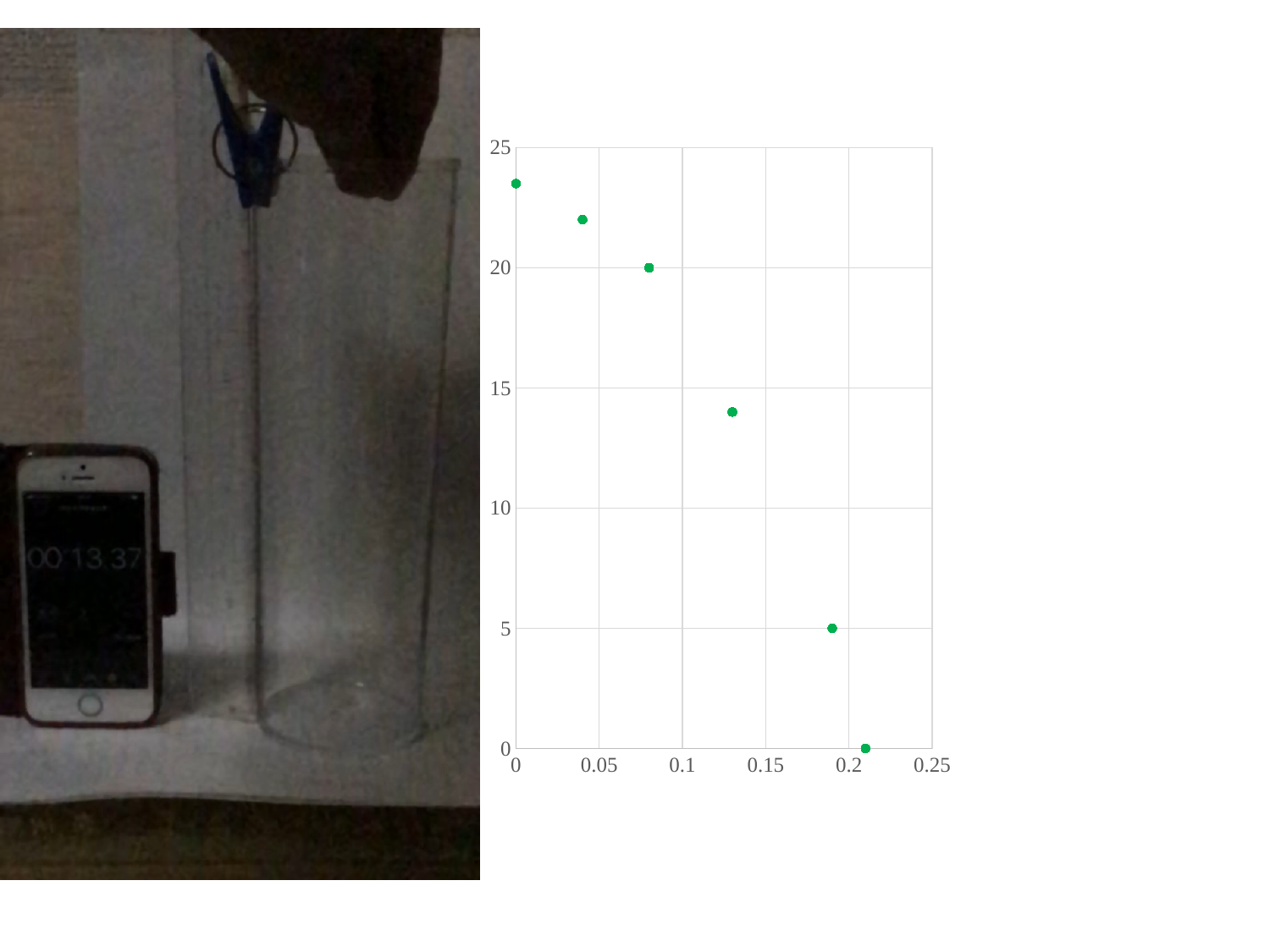
What is the y value of the rightmost point on the chart? 0 What is the highest value shown on the y axis? 25 Is the y value of the second point from the left greater or less than 20? greater Is the y value of the leftmost point greater or less than 20? greater Which point has the highest y value, the leftmost or the rightmost? the leftmost What kind of chart is shown on the slide? scatter chart What is the x value of the leftmost point on the chart? 0 Is the y value of the fourth point from the left greater or less than 15? less How many data points are plotted on the chart? 6 Do the plotted values rise or fall as the x value increases? fall What is the y value of the second point from the right on the chart? 5 What is the y value of the third point from the left on the chart? 20